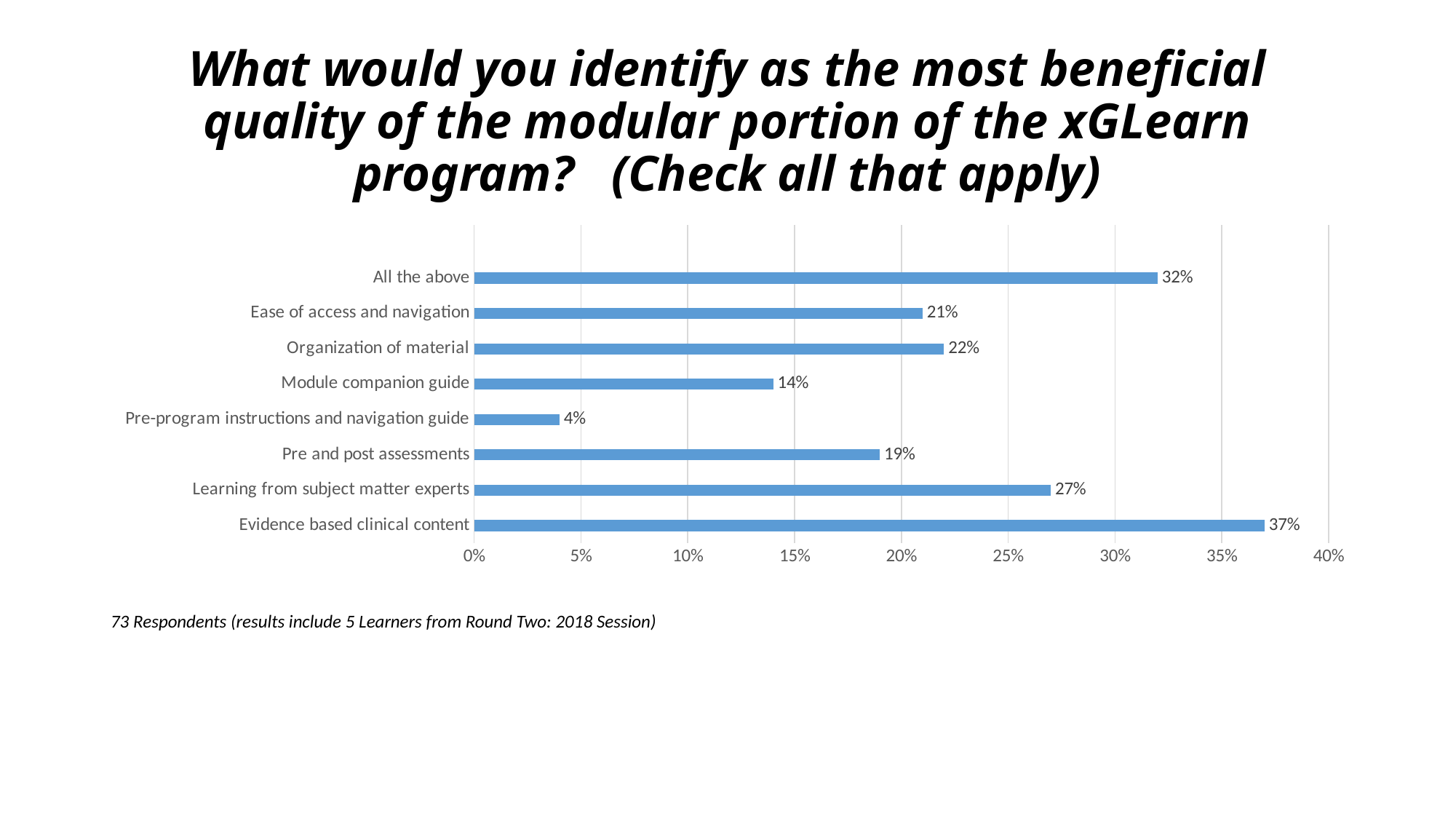
How many categories are shown in the chart? 8 Which is larger, Pre and post assessments or Module companion guide? Pre and post assessments Which category has the highest value? Evidence based clinical content What is the maximum value shown on the horizontal axis? 40% Is the value for Learning from subject matter experts greater or less than 25%? greater What is the difference between Evidence based clinical content and Learning from subject matter experts? 10% What is the value for Evidence based clinical content? 37% What is the value for Module companion guide? 14% Which category has the lowest value? Pre-program instructions and navigation guide What is the difference between Organization of material and Ease of access and navigation? 1% What kind of chart is shown on the slide? bar chart What is the value for All the above? 32%